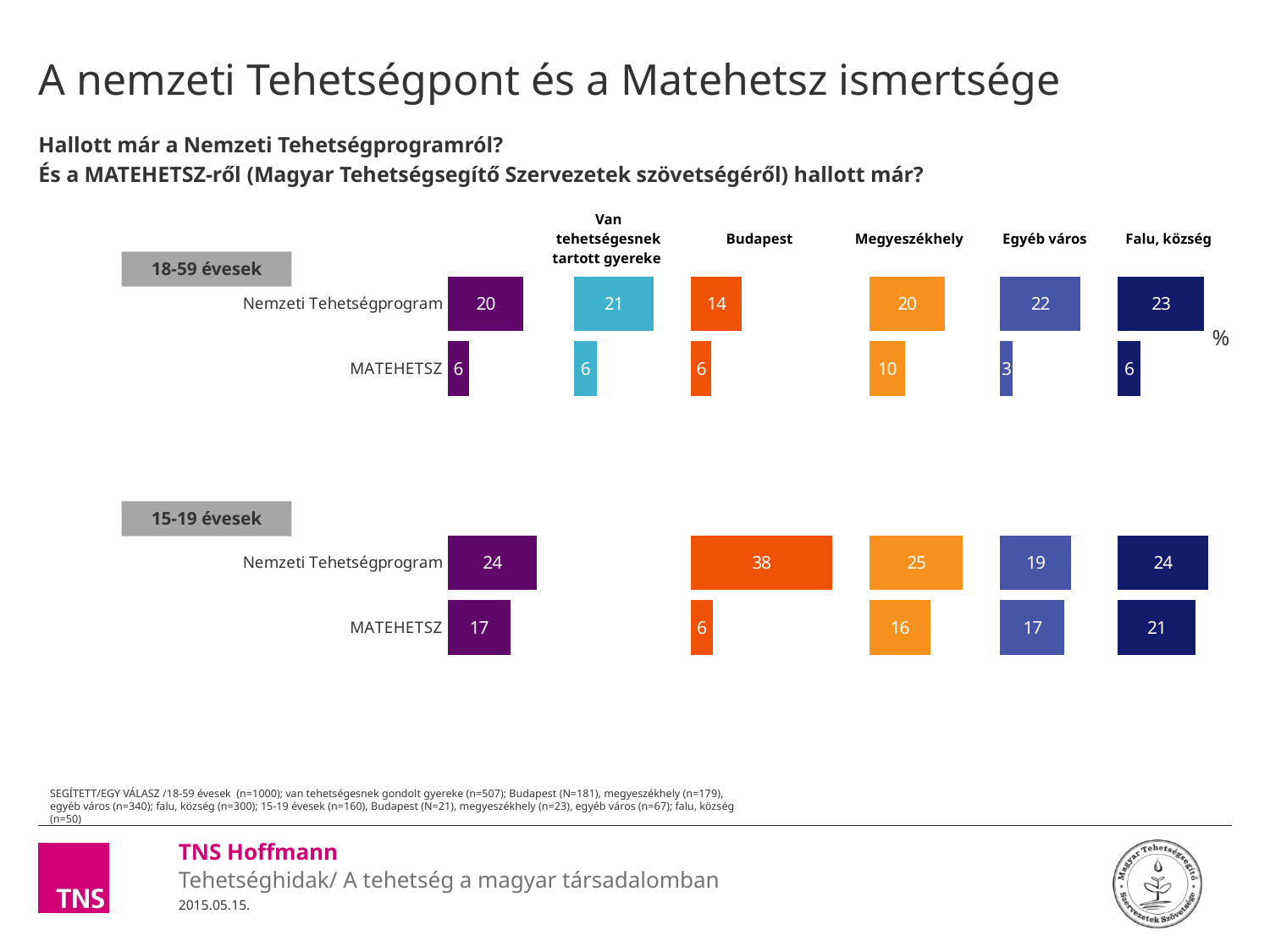
In the 18-59 évesek chart, which location has the lowest value for MATEHETSZ? Egyéb város In the 18-59 évesek chart, what is the value for MATEHETSZ in Megyeszékhely? 10 In the 18-59 évesek chart, what is the difference between the Nemzeti Tehetségprogram and MATEHETSZ values for Falu, község? 17 In the 15-19 évesek chart, what is the difference between the Nemzeti Tehetségprogram values for Budapest and Egyéb város? 19 In the 18-59 évesek chart, what is the value for Nemzeti Tehetségprogram in Egyéb város? 22 In the 15-19 évesek chart, what is the value for MATEHETSZ in Falu, község? 21 In the 15-19 évesek chart, what is the value for Nemzeti Tehetségprogram in Budapest? 38 What type of chart is used on this slide? Bar chart In the 15-19 évesek chart, which location has the highest value for Nemzeti Tehetségprogram? Budapest In the 18-59 évesek chart, which is larger for Nemzeti Tehetségprogram: Van tehetségesnek tartott gyereke or Budapest? Van tehetségesnek tartott gyereke In the 15-19 évesek chart, which is larger for MATEHETSZ: Budapest or Megyeszékhely? Megyeszékhely In the 18-59 évesek chart, what is the value for Nemzeti Tehetségprogram in Budapest? 14